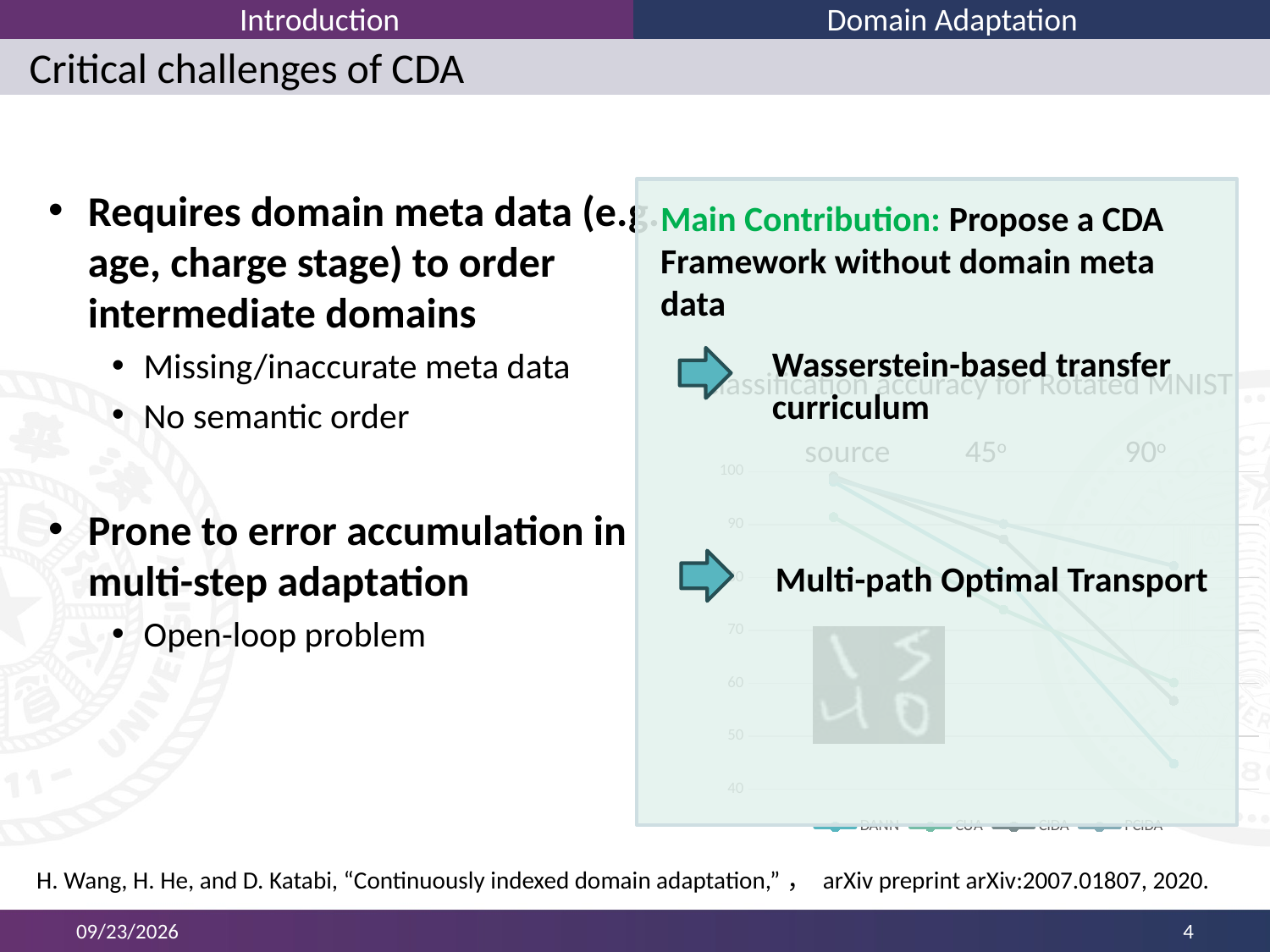
What is the title of the chart? Classification accuracy for Rotated MNIST Do the plotted values rise or fall from source to 90° along the x axis? fall How many series does the chart's legend list? 4 What kind of chart is shown on the slide? line chart Is the lowest plotted value at the source category greater or less than 80? greater Is the highest plotted value at the source category greater or less than 90? greater What are the three x-axis categories of the chart? source, 45°, 90° How many categories are shown along the x axis of the chart? 3 Is the lowest plotted value at 90° greater or less than 60? less Which x-axis category has the highest plotted values, source or 90°? source